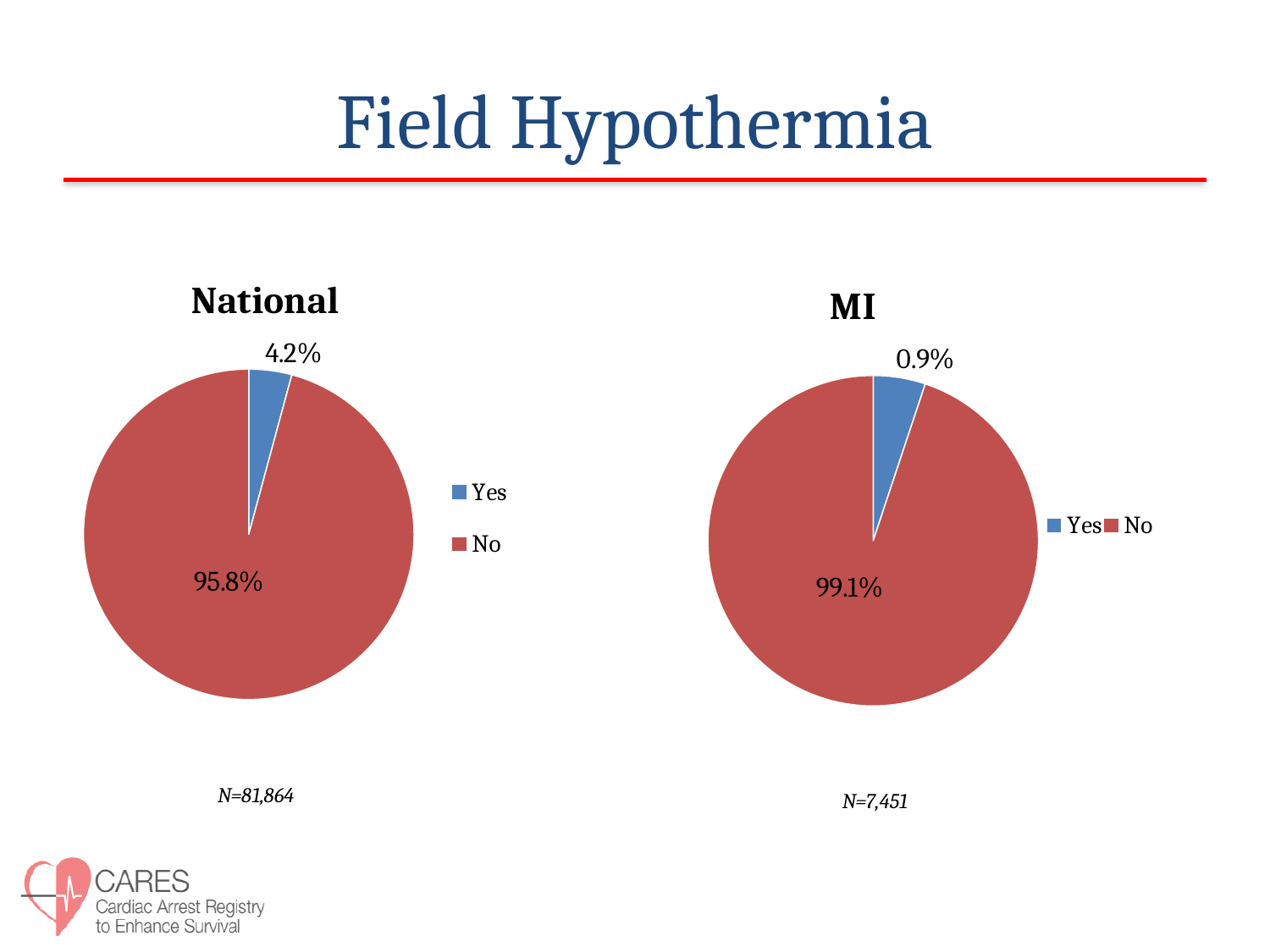
What type of chart is the MI chart? Pie chart Is the Yes share larger in the National chart or the MI chart? National In the MI chart, what percentage is shown for Yes? 0.9% In the National chart, what percentage is shown for No? 95.8% What is the N value shown below the MI chart? N=7,451 What is the difference between the Yes percentage in the National chart and the Yes percentage in the MI chart? 3.3% How many categories does the legend of the National chart list? 2 In the National chart, which category has the largest slice? No In the National chart, what percentage is shown for Yes? 4.2% In the MI chart, which category has the smallest slice? Yes In the National chart, what is the difference between the No and Yes percentages? 91.6% In the MI chart, what percentage is shown for No? 99.1%